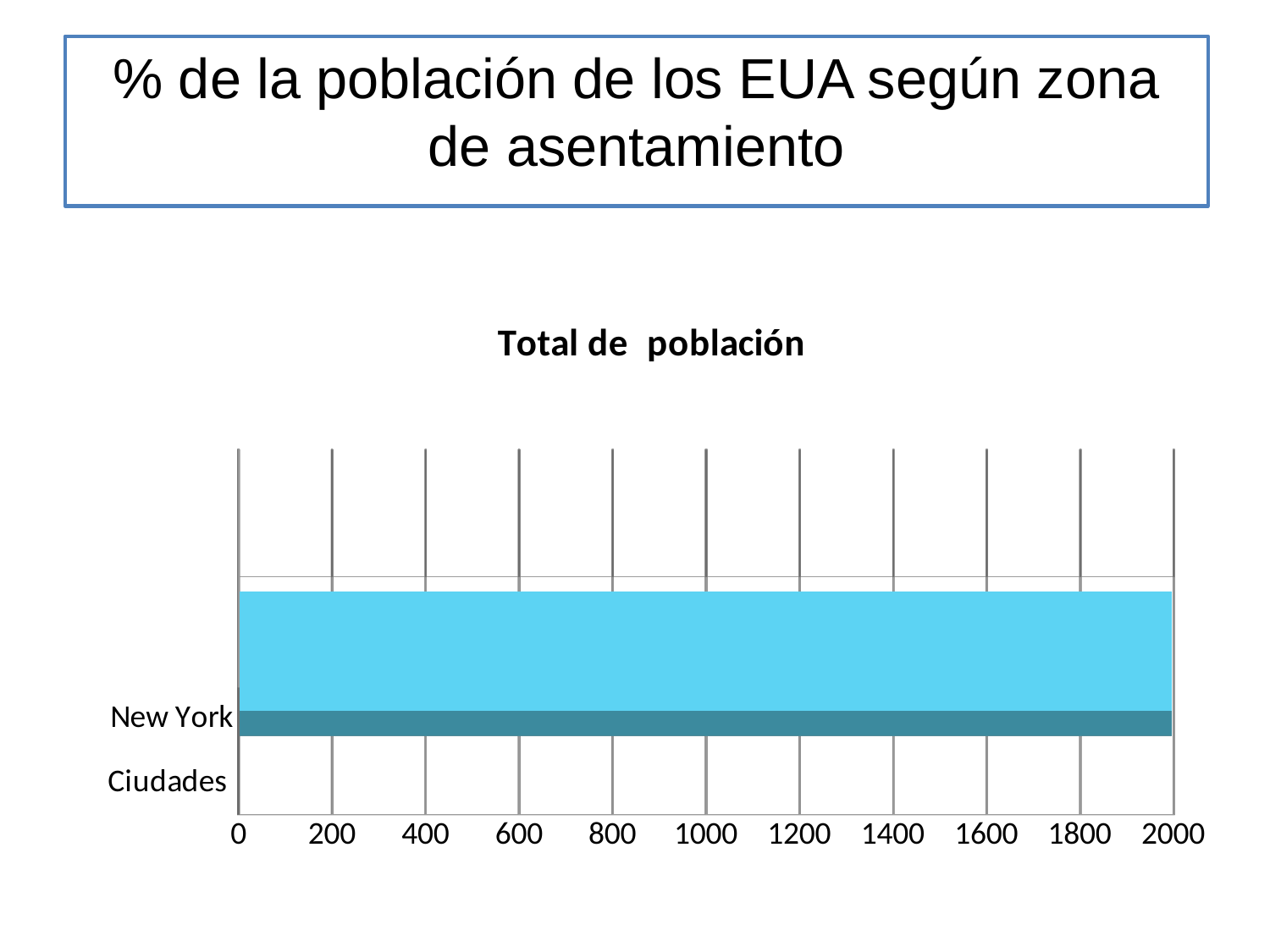
What kind of chart is shown on the slide? bar chart Which category has the smallest value in the chart? New York How many categories are listed on the vertical axis of the chart? 2 Which category has no visible bar in the chart? New York Is the value for New York greater or less than 1000? less Which category has the longest bar in the chart? Ciudades What is the title of the chart? Total de población What is the highest value shown on the horizontal axis? 2000 Which is larger, the value for New York or the value for Ciudades? Ciudades